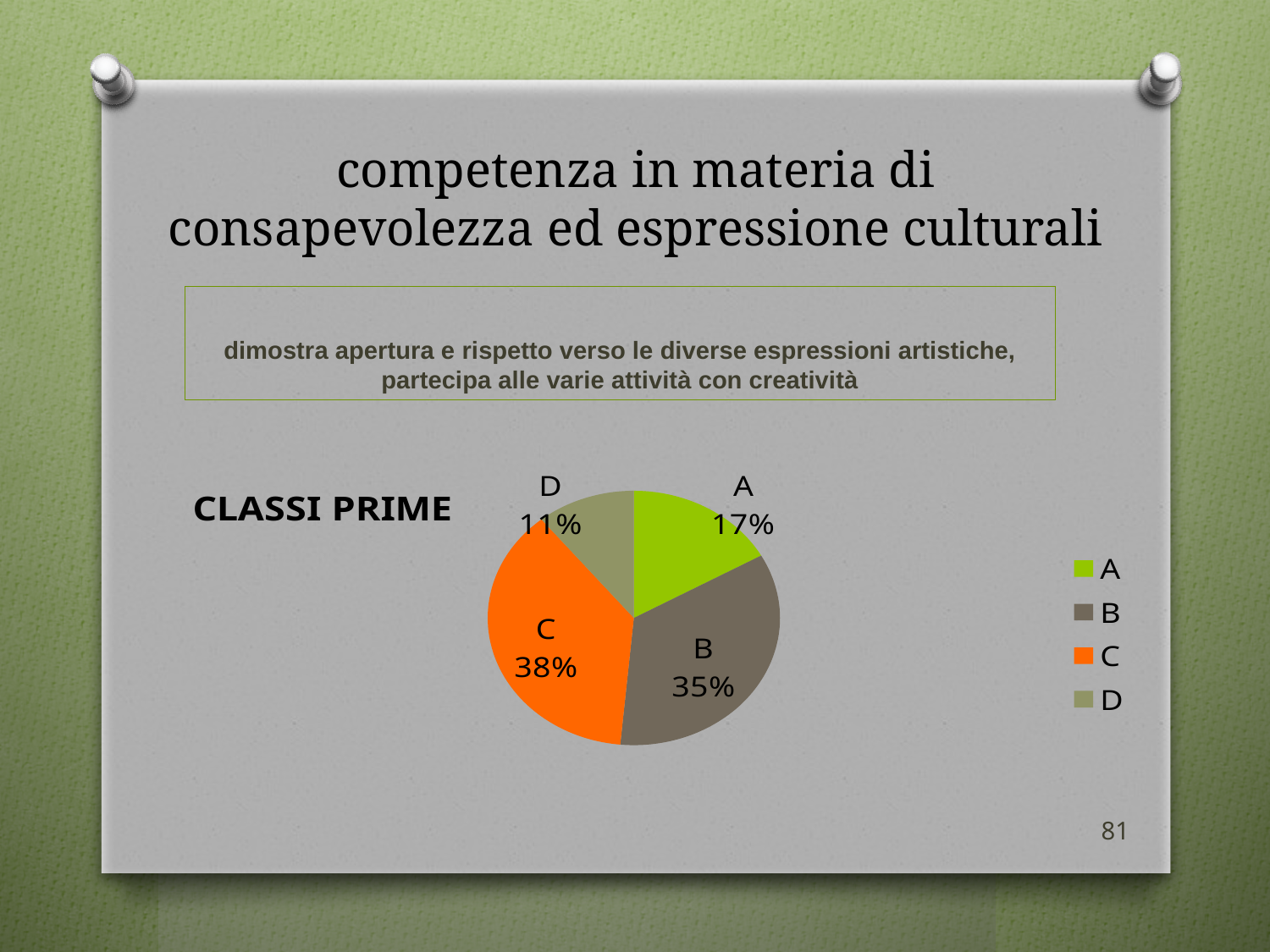
What is the difference in percentage points between category C and category A? 21 What label appears to the left of the pie chart? CLASSI PRIME How many categories are shown in the pie chart? 4 What percentage of the pie chart does category C represent? 38% Which category has the smallest share of the pie chart? D What percentage of the pie chart does category B represent? 35% What type of chart is shown on the slide? Pie chart What percentage of the pie chart does category D represent? 11% What colour is used for category C in the pie chart? Orange Which category has the largest share of the pie chart? C Which category has a larger share, A or B? B What percentage of the pie chart does category A represent? 17%